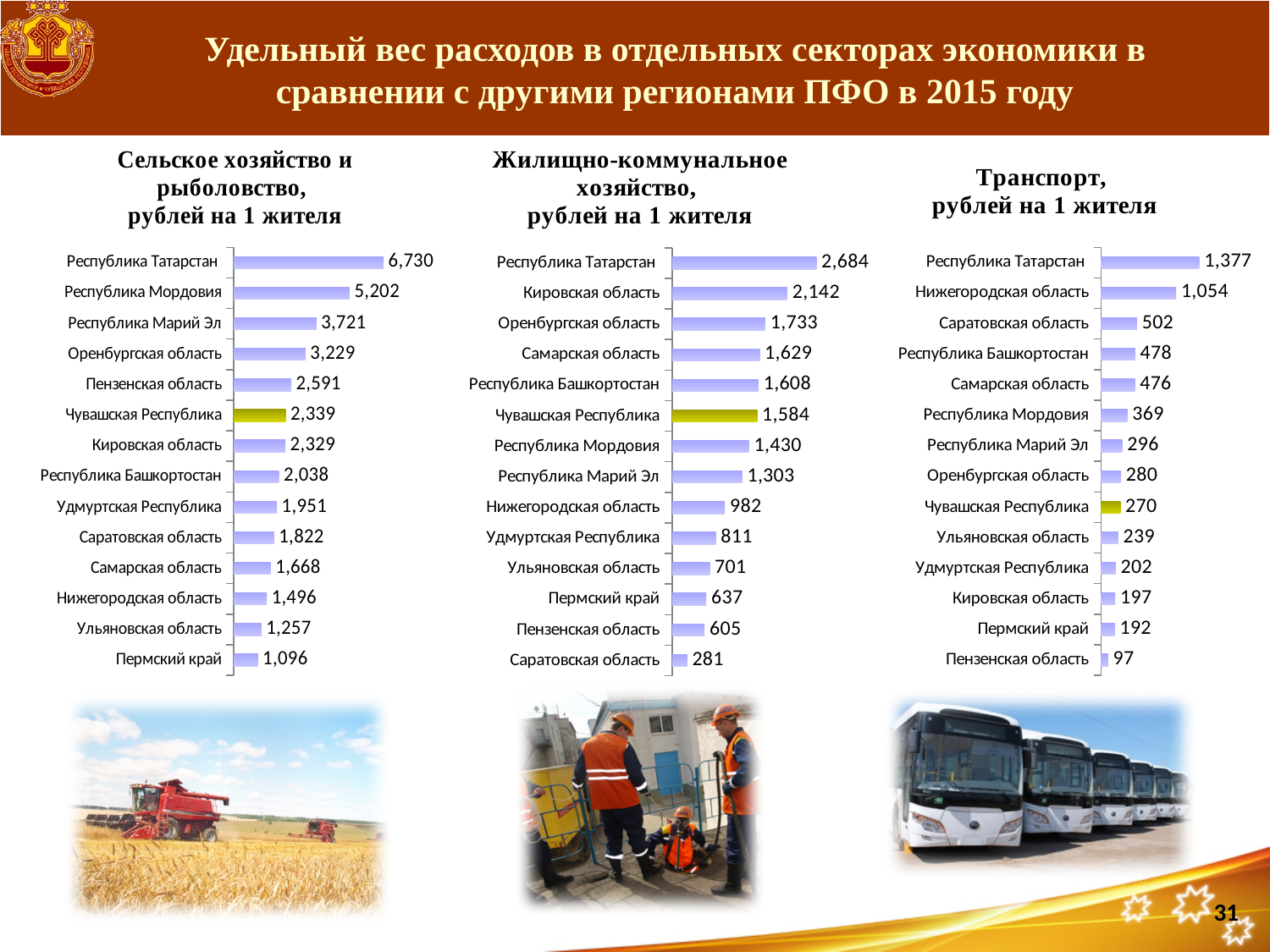
In the chart 'Жилищно-коммунальное хозяйство, рублей на 1 жителя', which is larger: Самарская область or Республика Мордовия? Самарская область In the chart 'Сельское хозяйство и рыболовство, рублей на 1 жителя', which region has the lowest value? Пермский край In the chart 'Сельское хозяйство и рыболовство, рублей на 1 жителя', which region has the highest value? Республика Татарстан In the chart 'Жилищно-коммунальное хозяйство, рублей на 1 жителя', which region has the lowest value? Саратовская область In the chart 'Транспорт, рублей на 1 жителя', what is the difference between Республика Татарстан and Пензенская область? 1,280 In the chart 'Транспорт, рублей на 1 жителя', which region's bar is highlighted in a different colour (yellow)? Чувашская Республика In the chart 'Жилищно-коммунальное хозяйство, рублей на 1 жителя', what is the value for Кировская область? 2,142 How many regions are shown in the chart 'Жилищно-коммунальное хозяйство, рублей на 1 жителя'? 14 In the chart 'Сельское хозяйство и рыболовство, рублей на 1 жителя', what is the value for Чувашская Республика? 2,339 In the chart 'Сельское хозяйство и рыболовство, рублей на 1 жителя', what is the difference between Республика Татарстан and Республика Мордовия? 1,528 In the chart 'Транспорт, рублей на 1 жителя', what is the value for Нижегородская область? 1,054 What type of chart is 'Транспорт, рублей на 1 жителя'? Bar chart